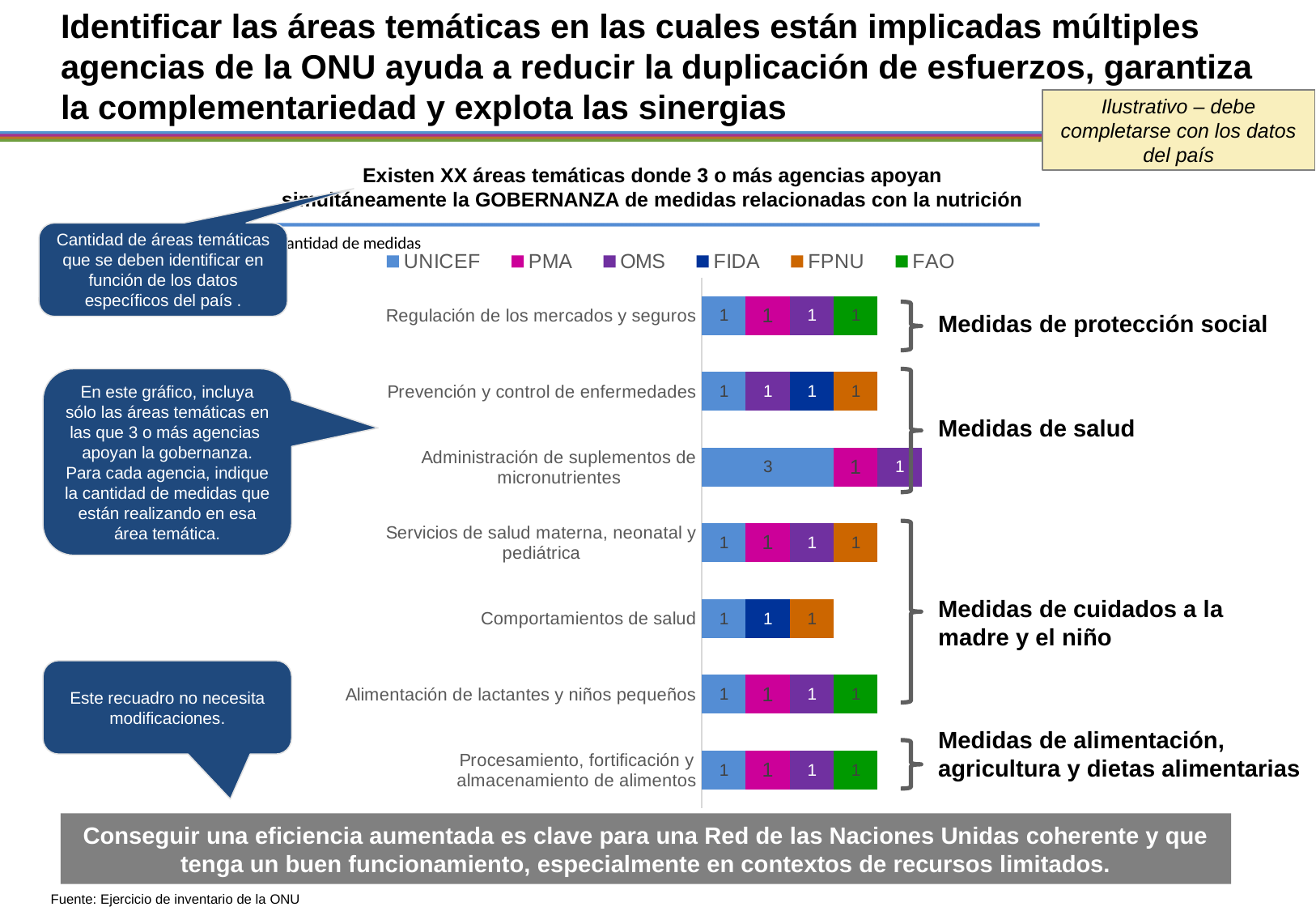
How many thematic areas (categories) are plotted in the chart? 7 What is the FPNU value for 'Comportamientos de salud'? 1 What kind of chart is shown on the slide? Stacked bar chart What is the difference between the UNICEF value for 'Administración de suplementos de micronutrientes' and the UNICEF value for 'Comportamientos de salud'? 2 What is the total of the stacked bar for 'Administración de suplementos de micronutrientes'? 5 Which legend entry is shown in green? FAO Which thematic area has the longest stacked bar? Administración de suplementos de micronutrientes Which thematic area has the shortest stacked bar? Comportamientos de salud What is the UNICEF value for 'Administración de suplementos de micronutrientes'? 3 Which is larger: the total for 'Administración de suplementos de micronutrientes' or the total for 'Regulación de los mercados y seguros'? Administración de suplementos de micronutrientes How many series does the chart legend list? 6 What is the total of the stacked bar for 'Comportamientos de salud'? 3